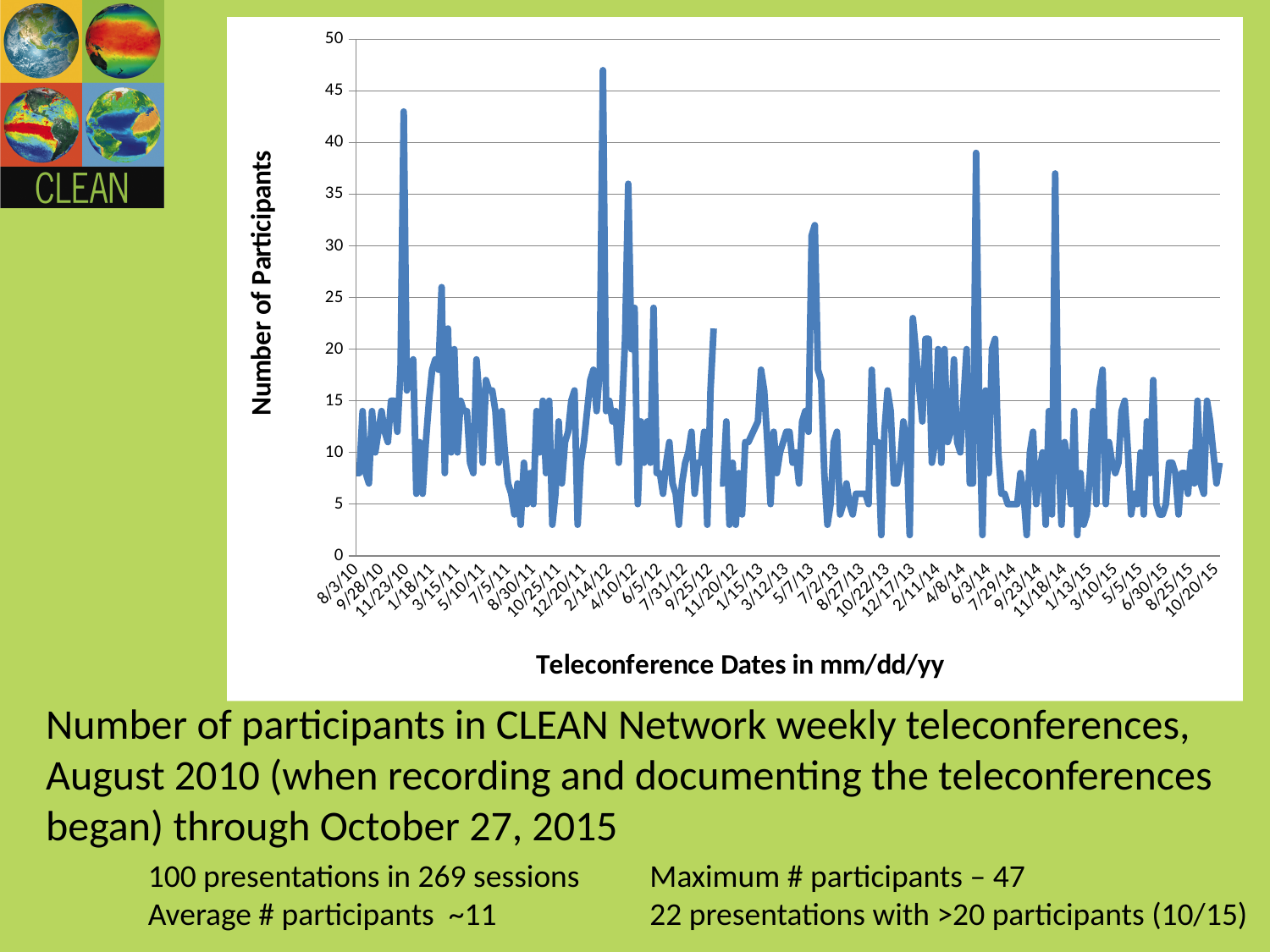
What is the highest value shown on the y axis of the chart? 50 Is the peak value near 7/2/13 greater or less than 30? greater Which peak is higher: the one near 2/14/12 or the one near 11/23/10? the one near 2/14/12 What is the label of the x axis of the chart? Teleconference Dates in mm/dd/yy How many data series are plotted in the chart? 1 What is the label of the y axis of the chart? Number of Participants What kind of chart is shown on the slide? line chart Is the peak value near 6/3/14 greater or less than 35? greater Is the peak value near 11/23/10 greater or less than 40? greater Which peak is higher: the one near 11/23/10 or the one near 7/2/13? the one near 11/23/10 What is the maximum number of participants reached in the chart? 47